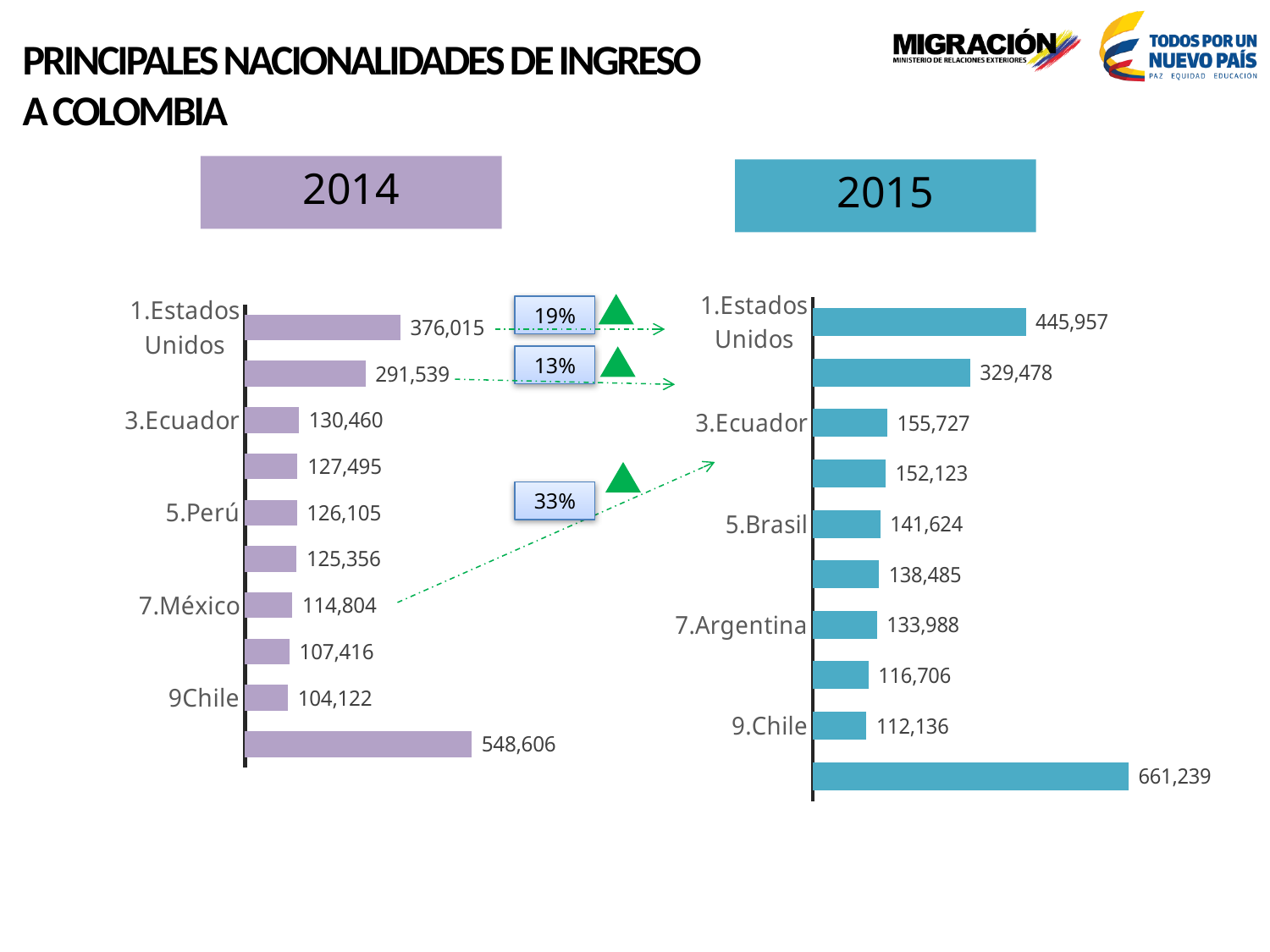
What kind of chart is the 2015 chart? Bar chart What is the difference between the 9.Chile value in the 2015 chart and the 9Chile value in the 2014 chart? 8,014 In the 2014 chart, what is the value for 5.Perú? 126,105 In the 2015 chart, what is the value for 1.Estados Unidos? 445,957 How many bars are plotted in the 2014 chart? 10 In the 2014 chart, what is the value for 7.México? 114,804 In the 2014 chart, which is larger: the value for 3.Ecuador or the value for 9Chile? 3.Ecuador In the 2015 chart, what is the value for 3.Ecuador? 155,727 What is the difference between the 1.Estados Unidos value in the 2015 chart and in the 2014 chart? 69,942 In the 2015 chart, what is the value for 7.Argentina? 133,988 In the 2015 chart, what is the value for 9.Chile? 112,136 In the 2014 chart, what is the value for 1.Estados Unidos? 376,015